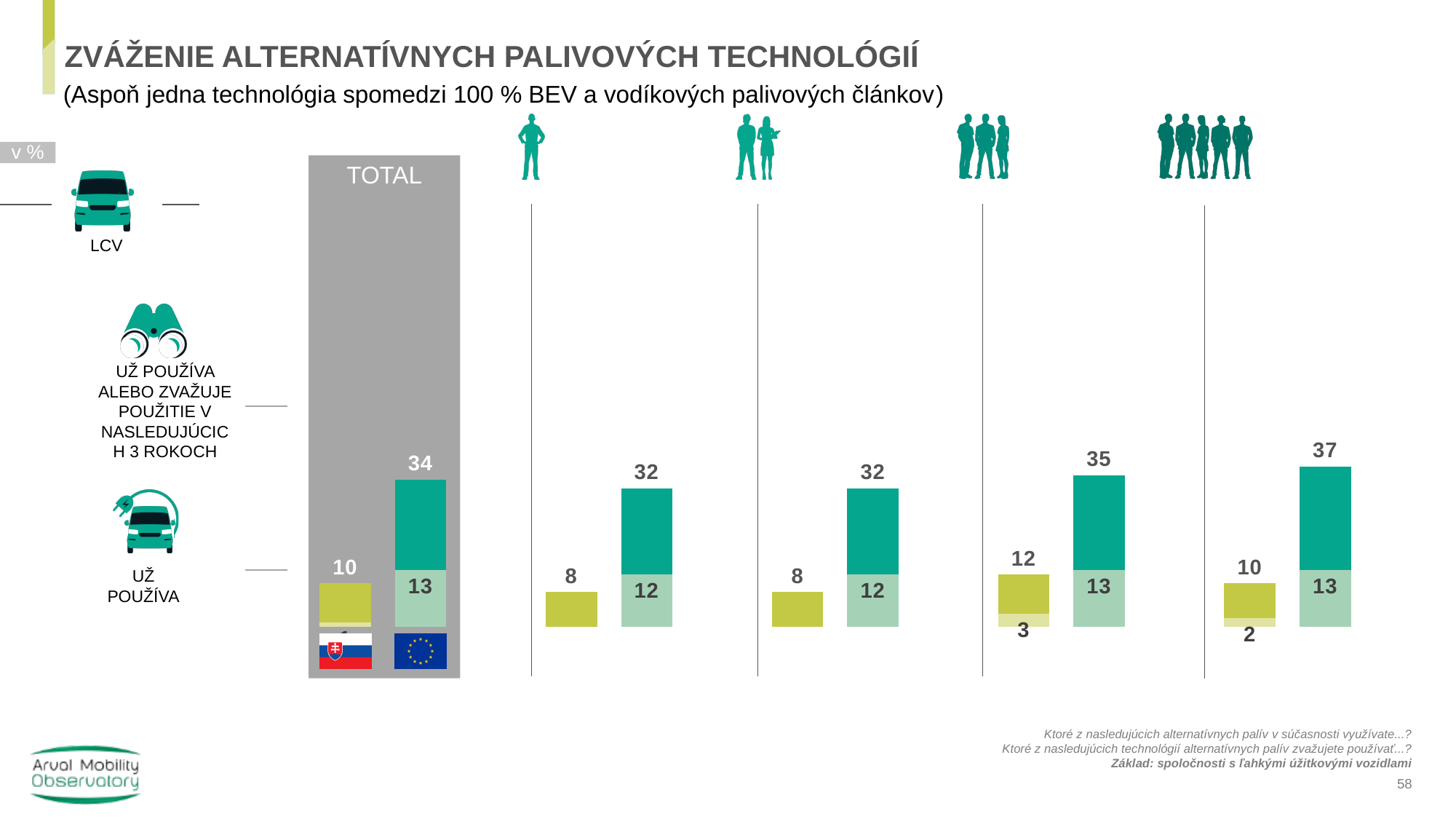
What is the difference between the EU and Slovak values for 'už používa alebo zvažuje použitie v nasledujúcich 3 rokoch' in the TOTAL column? 24 For the fourth (rightmost) company-size group, what is the Slovak value for 'už používa'? 2 Is the Slovak value for 'už používa alebo zvažuje použitie v nasledujúcich 3 rokoch' higher in the third group or the fourth group? The third group For the third company-size group from the left, what is the difference between the EU value (35) and the Slovak value (12) for 'už používa alebo zvažuje použitie v nasledujúcich 3 rokoch'? 23 What unit are the values on the chart expressed in? % In the TOTAL column, what is the EU value for 'už používa'? 13 Which company-size group has the highest EU value for 'už používa alebo zvažuje použitie v nasledujúcich 3 rokoch'? The fourth (rightmost) group In the TOTAL column, what is the EU value for 'už používa alebo zvažuje použitie v nasledujúcich 3 rokoch'? 34 For the third company-size group from the left, what is the Slovak value for 'už používa'? 3 What type of chart is shown on the slide? Bar chart For the fourth (rightmost) company-size group, what is the EU value for 'už používa alebo zvažuje použitie v nasledujúcich 3 rokoch'? 37 In the TOTAL column, what is the Slovak value for 'už používa alebo zvažuje použitie v nasledujúcich 3 rokoch'? 10